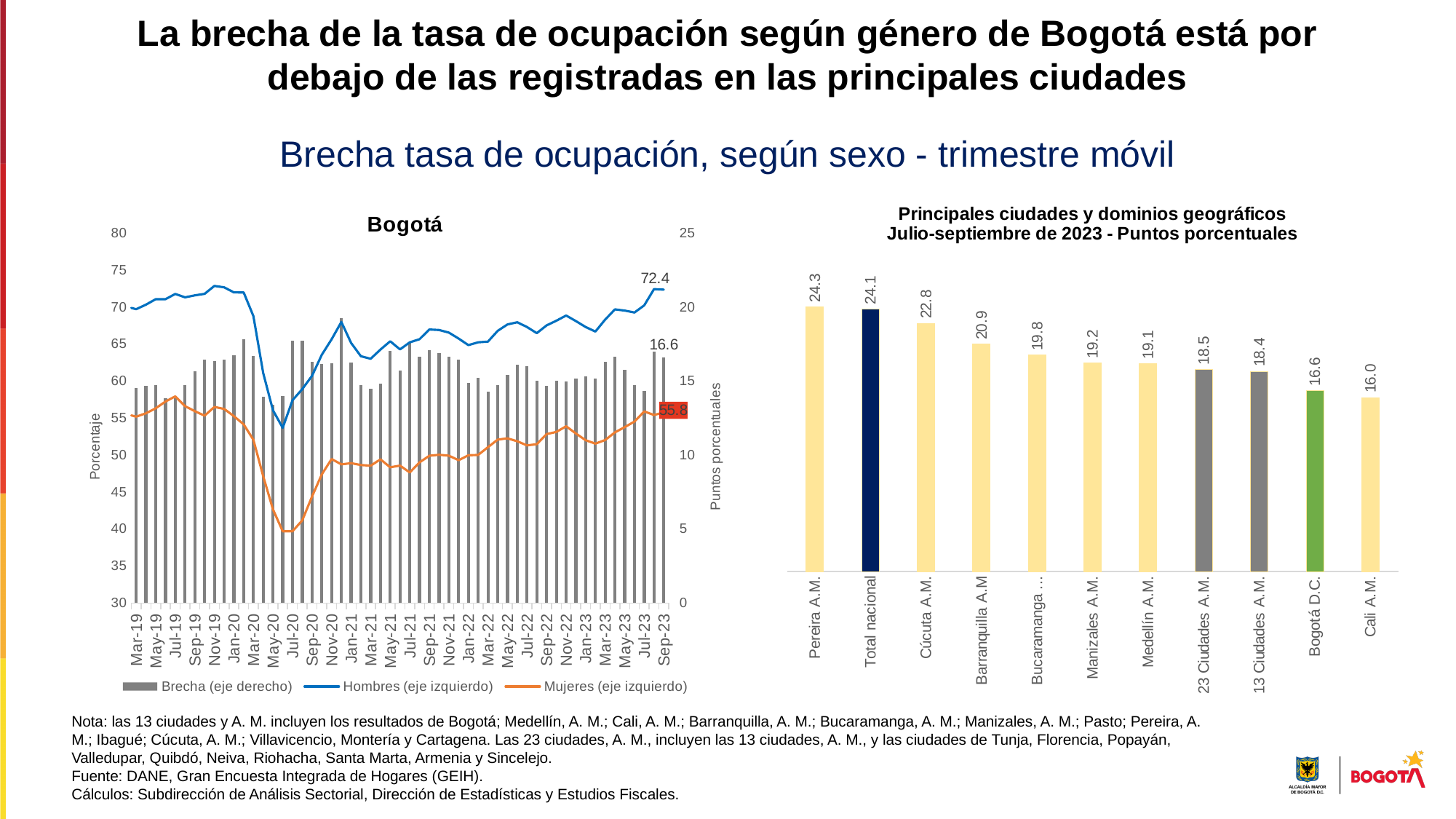
In the left chart (Bogotá), what is the value of the Mujeres series for Sep-23? 55.8 In the right chart (Principales ciudades y dominios geográficos), what is the difference between the values for Pereira A.M. and Bogotá D.C.? 7.7 In the right chart (Principales ciudades y dominios geográficos), which category has the lowest value? Cali A.M. In the left chart (Bogotá), what is the value of the Hombres series for Sep-23? 72.4 In the right chart (Principales ciudades y dominios geográficos), which has the larger value, Manizales A.M. or Medellín A.M.? Manizales A.M. In the right chart (Principales ciudades y dominios geográficos), what is the value for Bogotá D.C.? 16.6 In the left chart (Bogotá), is the value of the Hombres series for Mar-19 greater or less than 65? greater How many series does the legend of the left chart (Bogotá) list? 3 In the left chart (Bogotá), what is the value of the Brecha series for Sep-23? 16.6 In the right chart (Principales ciudades y dominios geográficos), what is the value for Cúcuta A.M.? 22.8 In the right chart (Principales ciudades y dominios geográficos), which category has the highest value? Pereira A.M. How many categories are shown in the right chart (Principales ciudades y dominios geográficos)? 11